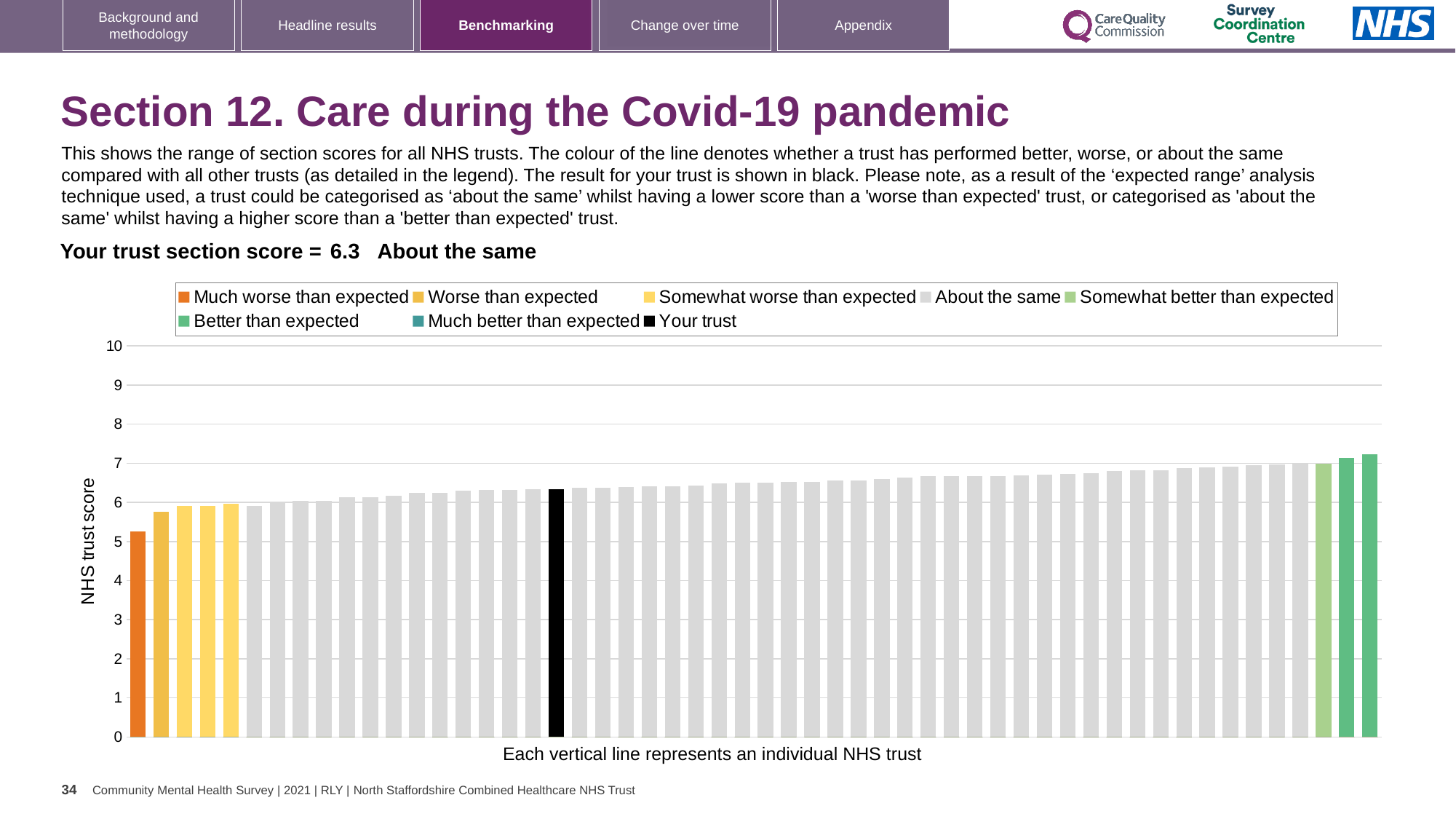
How many bars are coloured dark green ('Better than expected')? 2 Do the bar values rise or fall from left to right along the x axis? Rise What type of chart is shown on the slide? Bar chart Which legend category does your trust's section score fall into? About the same Which is larger: the black 'Your trust' bar or the orange 'Much worse than expected' bar? Your trust Is the value of the black 'Your trust' bar greater or less than 6? greater Is the value of the orange 'Much worse than expected' bar greater or less than 5? greater How many bars are coloured orange ('Much worse than expected')? 1 Is the value of the tallest bar in the chart greater or less than 8? less What is the section score for your trust shown on the slide? 6.3 What is the label on the vertical axis of the chart? NHS trust score How many entries does the chart legend list? 8